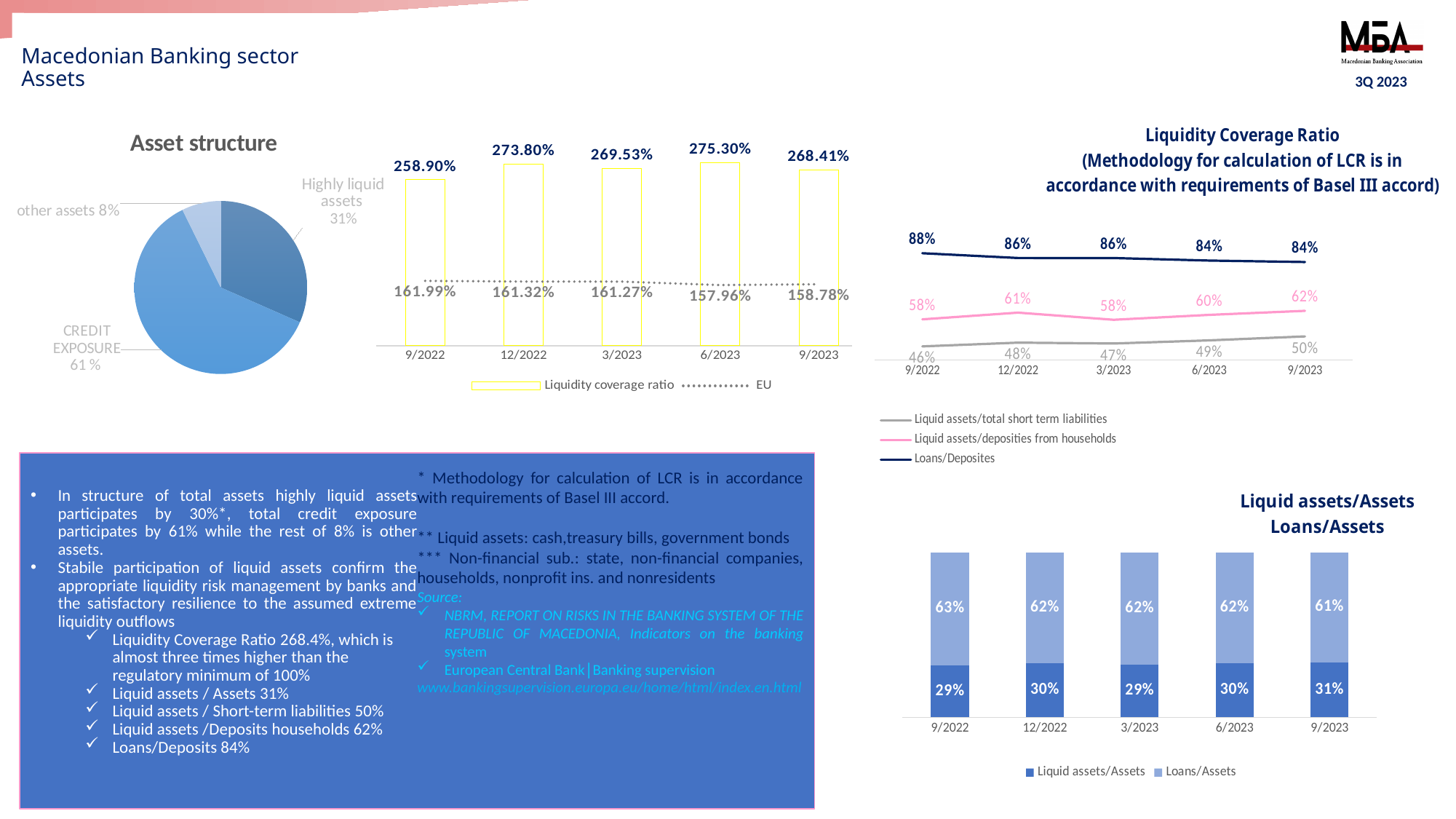
In the Liquidity coverage ratio bar chart, which period has the lowest Liquidity coverage ratio? 9/2022 In the Liquidity coverage ratio bar chart, what is the Liquidity coverage ratio for 6/2023? 275.30% In the Asset structure pie chart, how many slices are there? 3 In the Liquidity coverage ratio bar chart, what is the difference between the Liquidity coverage ratio and the EU value for 9/2022? 96.91% In the Liquid assets/Assets Loans/Assets chart, what is the Liquid assets/Assets value for 9/2023? 31% In the Asset structure pie chart, what share do highly liquid assets have? 31% In the Asset structure pie chart, which slice is the largest? CREDIT EXPOSURE What kind of chart is the Liquid assets/Assets Loans/Assets chart? stacked bar chart In the Liquidity Coverage Ratio line chart on the right, does the Liquid assets/total short term liabilities series rise or fall from 9/2022 to 9/2023? rise In the Liquidity Coverage Ratio line chart on the right, how many series does the legend list? 3 In the Liquidity coverage ratio bar chart, what is the EU value for 9/2023? 158.78% In the Liquidity Coverage Ratio line chart on the right, what is the Loans/Deposites value for 9/2022? 88%